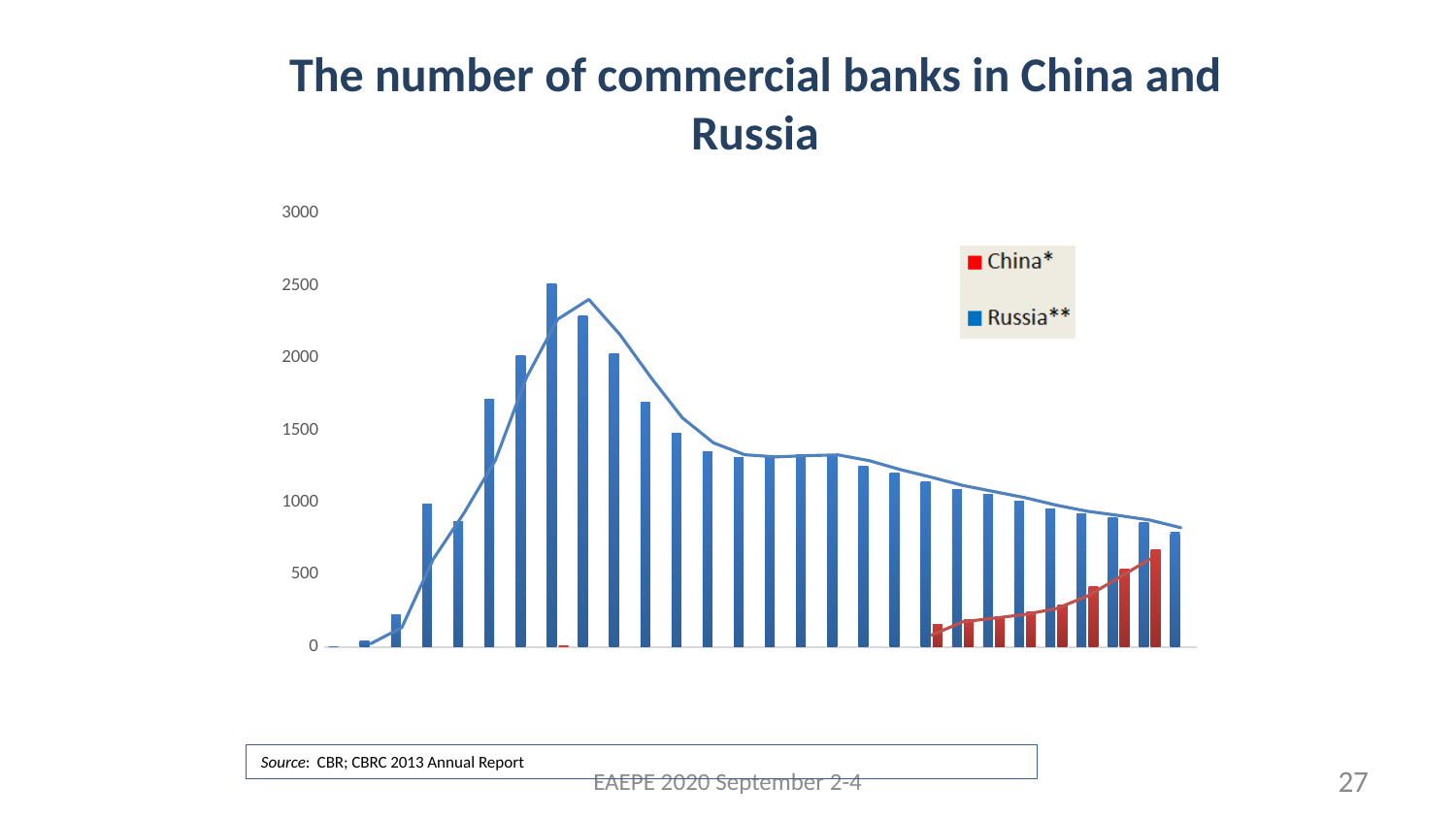
Is the last (rightmost) value for Russia** greater or less than 1000? less Which series is shown in red in the legend? China* Do the values for China* rise or fall along the x axis? rise What kind of chart is shown on the slide? bar chart Which series reaches the higher peak value, China* or Russia**? Russia** Is the highest value for China* greater or less than 1000? less What is the title of the chart? The number of commercial banks in China and Russia What is the maximum value shown on the vertical axis? 3000 How many series does the legend list? 2 Is the highest value for Russia** greater or less than 2000? greater After reaching their peak, do the values for Russia** rise or fall along the x axis? fall